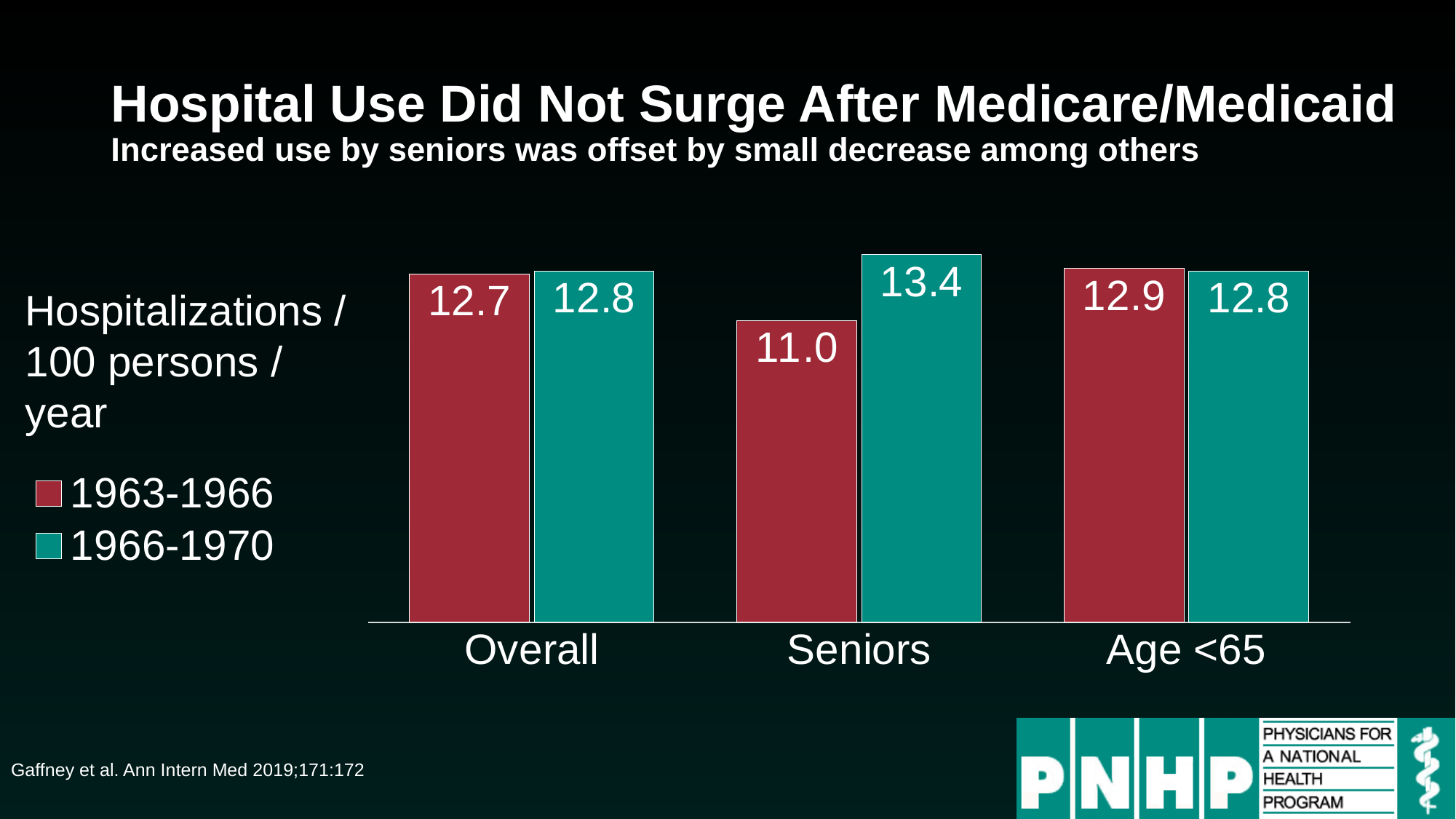
What is the value for Seniors in 1963-1966? 11.0 What unit is the y axis measured in, according to the label on the left? Hospitalizations / 100 persons / year What kind of chart is shown on the slide? Bar chart What is the Overall value for 1966-1970? 12.8 For Age <65, which period has the larger value, 1963-1966 or 1966-1970? 1963-1966 What is the value for Age <65 in 1963-1966? 12.9 What is the value for Seniors in 1966-1970? 13.4 Which category has the highest value in the 1966-1970 series? Seniors How many series does the legend list? 2 How many categories are shown on the x axis? 3 What is the difference between the 1966-1970 and 1963-1966 values for Seniors? 2.4 Which category has the lowest value in the 1963-1966 series? Seniors